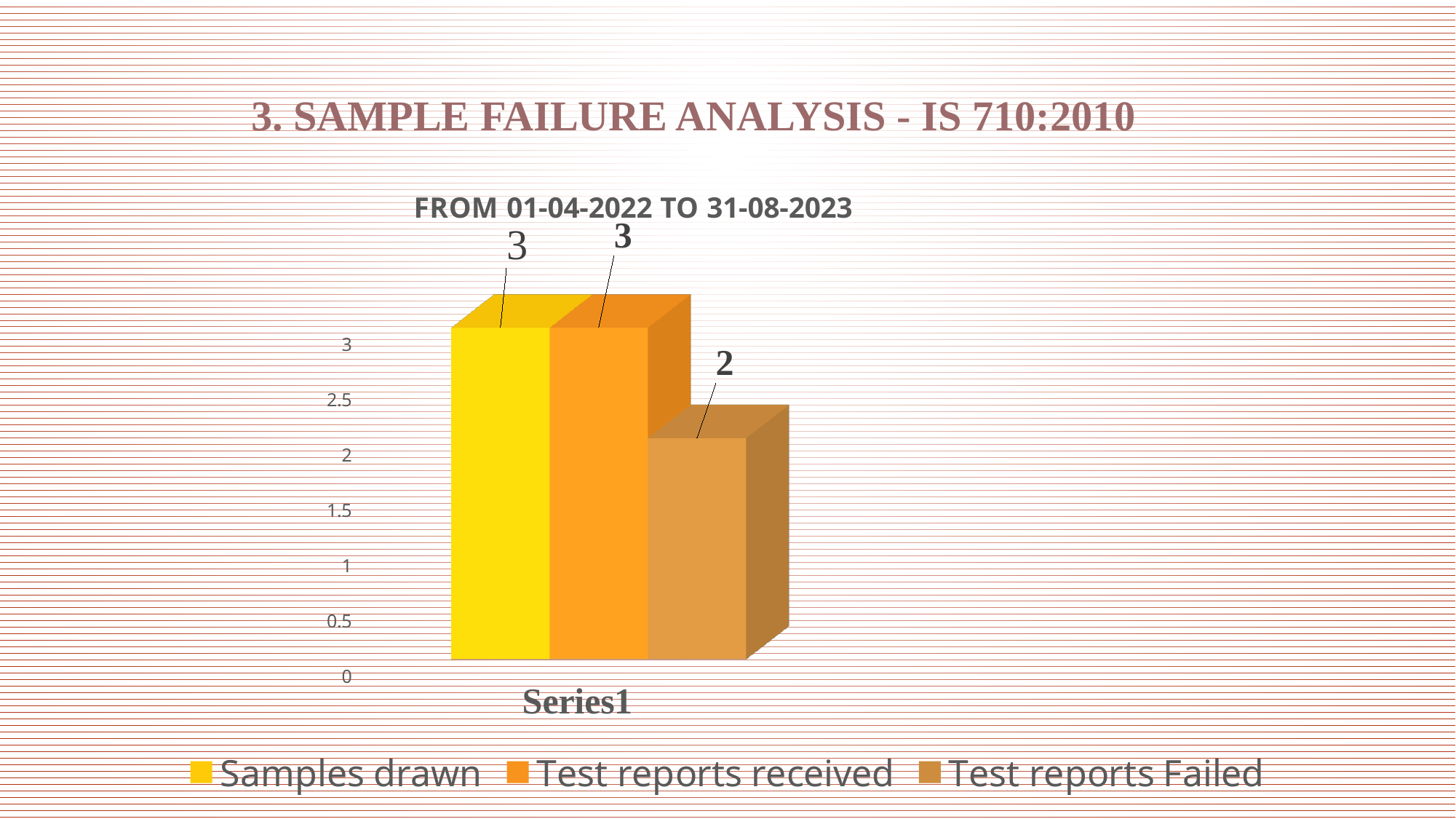
What is the difference between Test reports received and Test reports Failed? 1 What kind of chart is shown? bar chart What is the difference between Samples drawn and Test reports received? 0 What is the value for Test reports Failed? 2 How many series does the legend list? 3 What is the value for Samples drawn? 3 Which series has the lowest value? Test reports Failed What is the category label on the x axis? Series1 Which is larger, Samples drawn or Test reports Failed? Samples drawn What is the value for Test reports received? 3 Is the value for Test reports Failed greater or less than 2.5? less What is the chart's title? FROM 01-04-2022 TO 31-08-2023